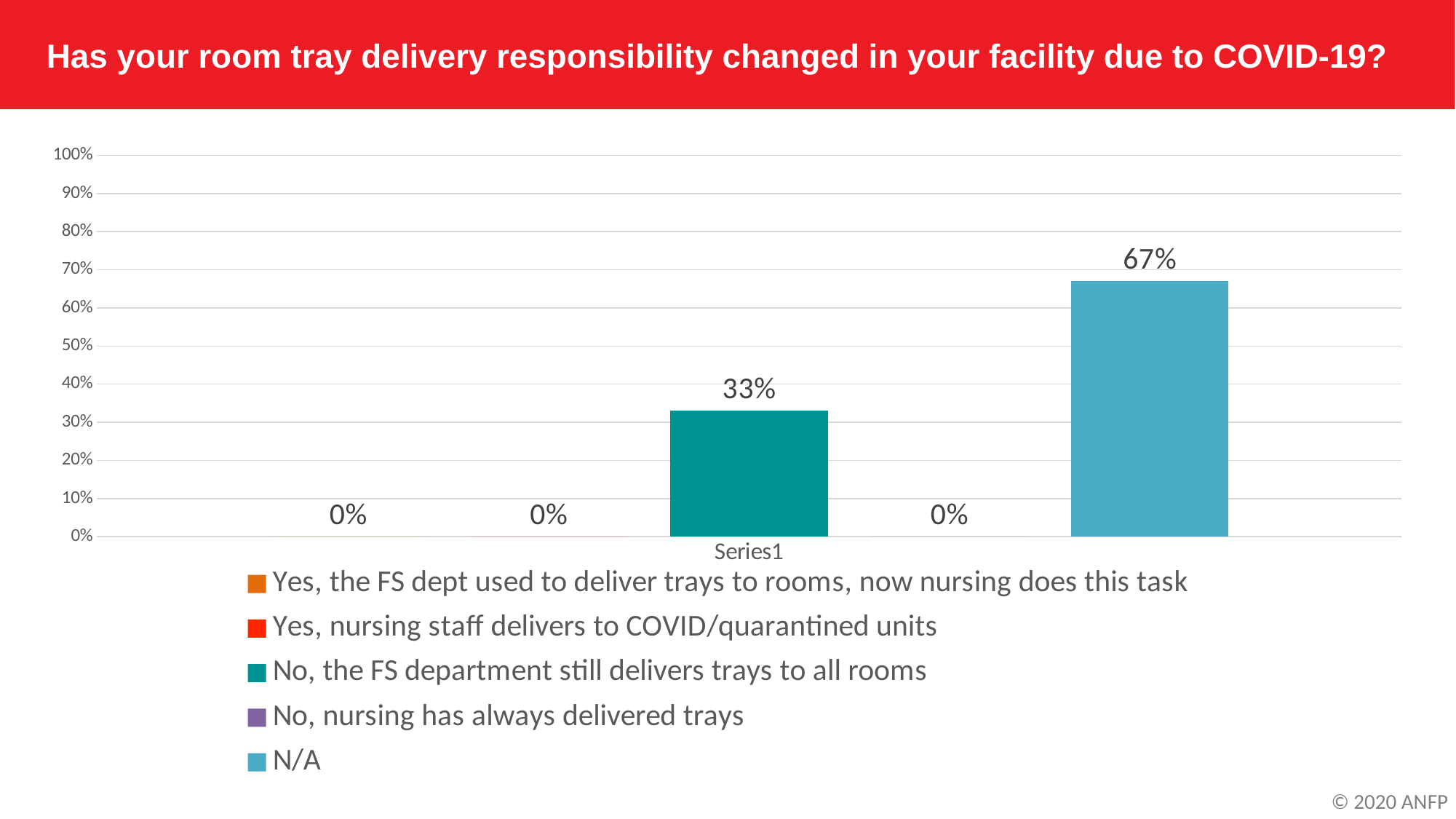
What colour is the bar for "No, the FS department still delivers trays to all rooms"? teal What is the difference between the values for "N/A" and "No, the FS department still delivers trays to all rooms"? 34% What percentage is shown for "N/A"? 67% How many series does the legend list? 5 What percentage is shown for "No, the FS department still delivers trays to all rooms"? 33% What is the title of the chart? Has your room tray delivery responsibility changed in your facility due to COVID-19? What percentage is shown for "Yes, nursing staff delivers to COVID/quarantined units"? 0% What kind of chart is shown on the slide? bar chart Is the value for "N/A" greater or less than 50%? greater How many legend entries have a value of 0%? 3 Which legend entry has the highest value? N/A Which is larger: the value for "N/A" or the value for "No, the FS department still delivers trays to all rooms"? N/A